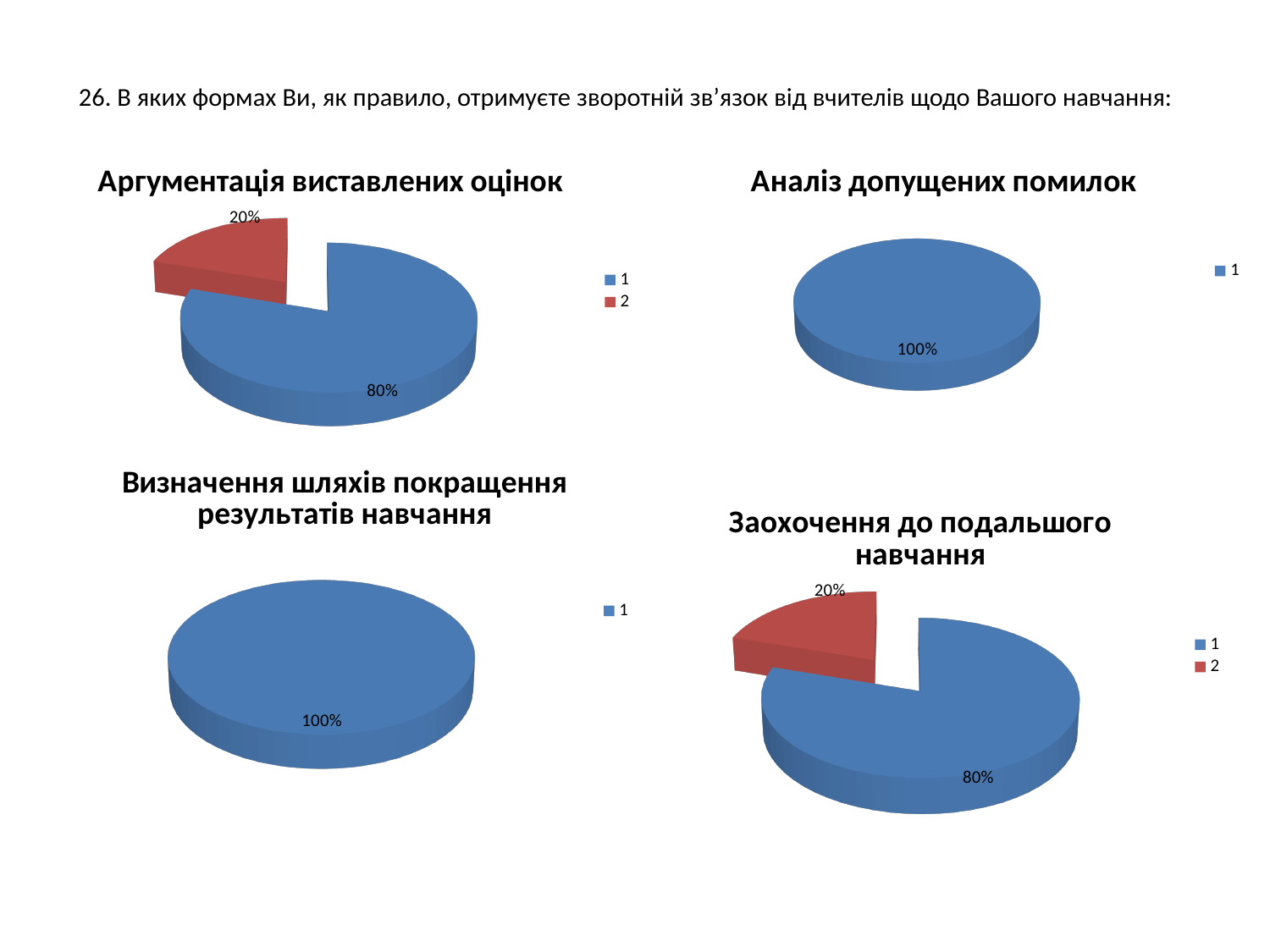
In the chart titled "Заохочення до подальшого навчання", which category has the smallest slice? 2 What kind of chart is the chart titled "Заохочення до подальшого навчання"? pie chart In the chart titled "Заохочення до подальшого навчання", is the slice for category 1 larger or smaller than the slice for category 2? larger In the chart titled "Аргументація виставлених оцінок", what is the difference between the shares of category 1 and category 2? 60% In the chart titled "Аргументація виставлених оцінок", what share does category 1 have? 80% How many categories does the legend list in the chart titled "Аналіз допущених помилок"? 1 In the chart titled "Аргументація виставлених оцінок", what share does category 2 have? 20% How many charts are shown on the slide? 4 In the chart titled "Аналіз допущених помилок", what share does category 1 have? 100% In the chart titled "Заохочення до подальшого навчання", what share does category 2 have? 20% In the chart titled "Визначення шляхів покращення результатів навчання", what share does category 1 have? 100% In the chart titled "Аргументація виставлених оцінок", which category has the largest slice? 1